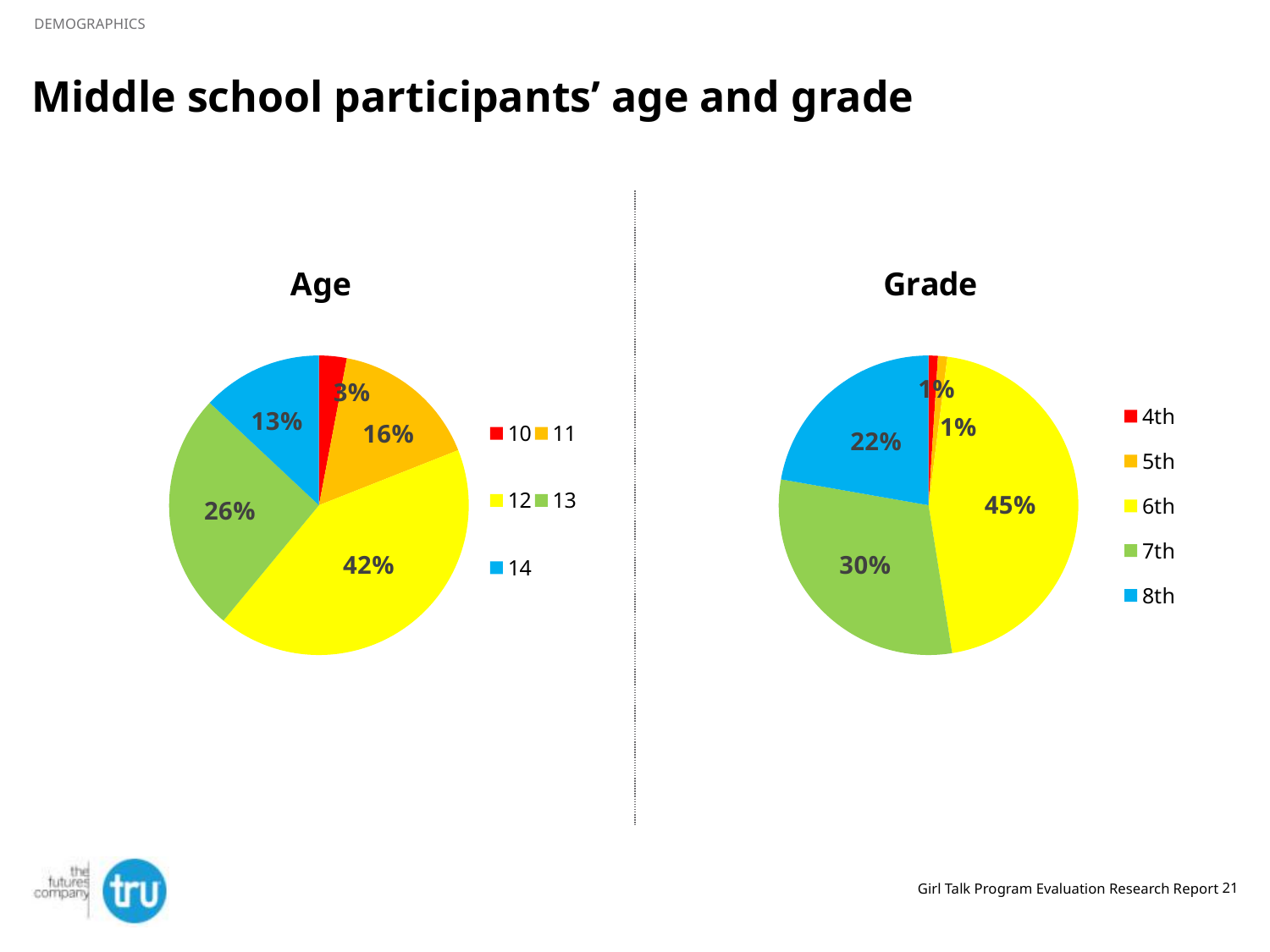
In the Age chart, what is the difference between the shares for age 13 and age 11? 10% In the Grade chart, what share of participants are in 6th grade? 45% In the Age chart, which age has the smallest share? 10 In the Grade chart, what share of participants are in 8th grade? 22% In the Age chart, how many age categories are shown? 5 In the Age chart, which age has the largest share? 12 In the Grade chart, which is larger, the share for 7th grade or 8th grade? 7th In the Age chart, what share of participants are age 12? 42% In the Age chart, what share of participants are age 14? 13% In the Grade chart, what is the difference between the shares for 6th grade and 7th grade? 15% What type of chart is the Grade chart? Pie chart In the Grade chart, which grade has the largest share? 6th